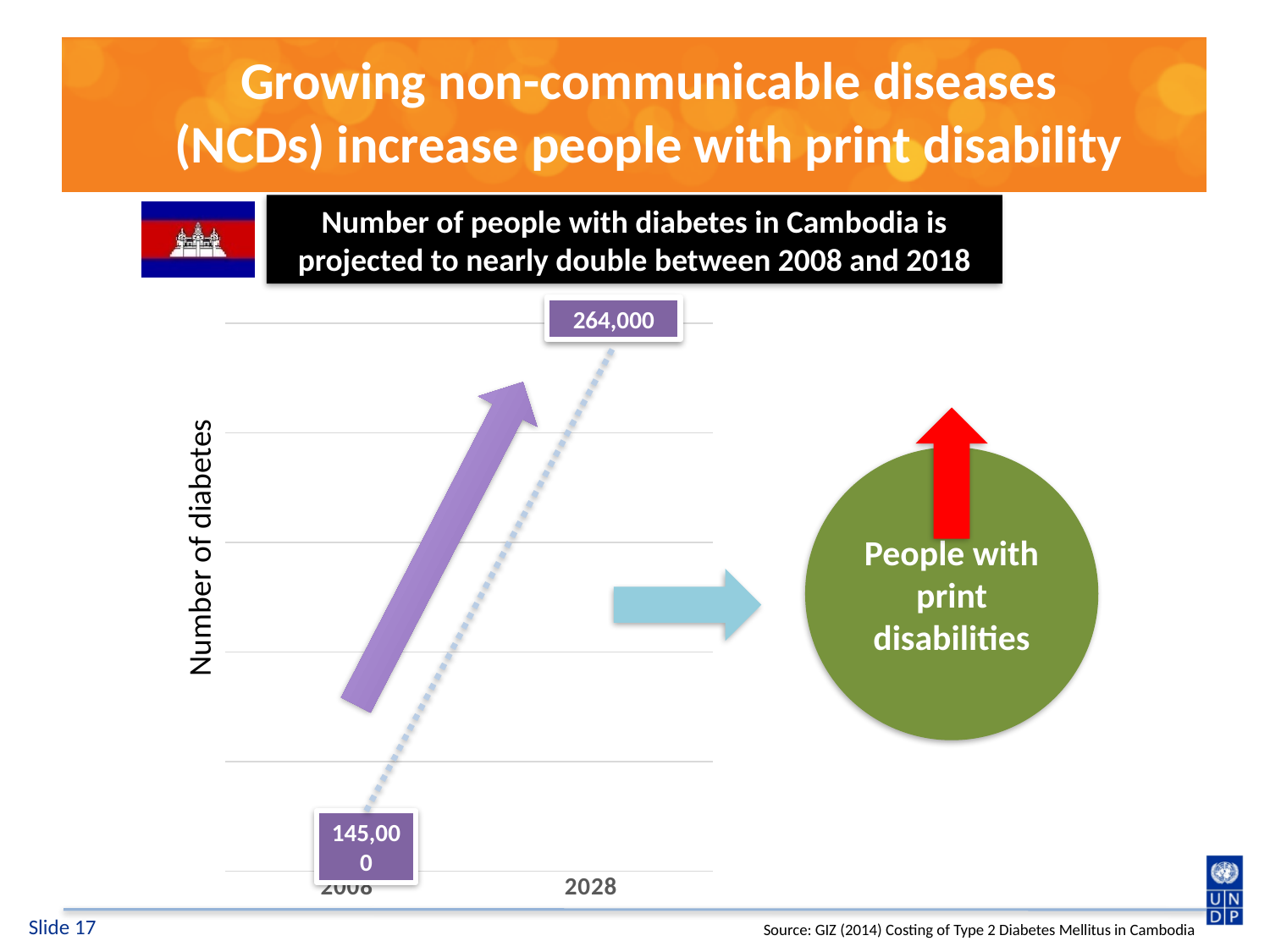
What is the title of the vertical axis of the chart? Number of diabetes How many data points are plotted on the chart? 2 Does the number of people with diabetes rise or fall from 2008 to 2028? rise What is the difference between the 2028 value and the 2008 value? 119,000 Which year has the lower number of people with diabetes? 2008 What source is cited for the chart data? GIZ (2014) Costing of Type 2 Diabetes Mellitus in Cambodia What is the number of people with diabetes shown for 2008? 145,000 Is the value for 2028 larger or smaller than the value for 2008? larger What is the number of people with diabetes shown for 2028? 264,000 What kind of chart is shown on the slide? line chart Which year has the higher number of people with diabetes? 2028